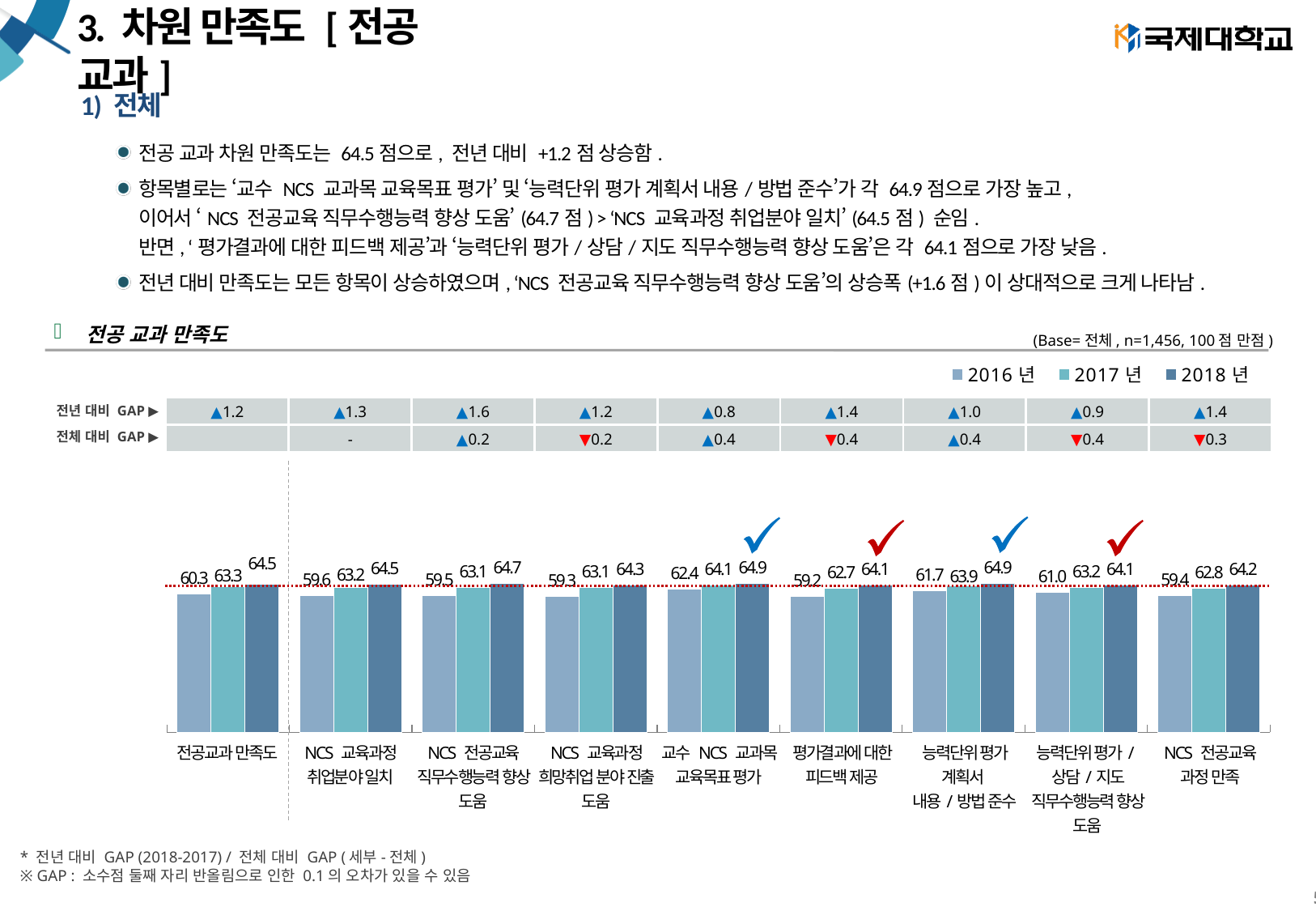
Which is larger, the 2018년 value for 교수 NCS 교과목 교육목표 평가 or the 2018년 value for 평가결과에 대한 피드백 제공? 교수 NCS 교과목 교육목표 평가 What is the 2018년 value for 전공교과 만족도? 64.5 What is the 2016년 value for 평가결과에 대한 피드백 제공? 59.2 Which category has the lowest 2016년 value? 평가결과에 대한 피드백 제공 What is the title of the chart? 전공 교과 만족도 What kind of chart is shown on the slide? bar chart How many categories are shown along the x axis of the chart? 9 What is the 2017년 value for 능력단위 평가 계획서 내용/방법 준수? 63.9 What is the 전년 대비 GAP shown above the NCS 전공교육 직무수행능력 향상 도움 category? ▲1.6 Do the values for NCS 전공교육 과정 만족 rise or fall from 2016년 to 2018년? rise What is the difference between the 2018년 and 2016년 values for NCS 전공교육 직무수행능력 향상 도움? 5.2 How many series does the legend list? 3